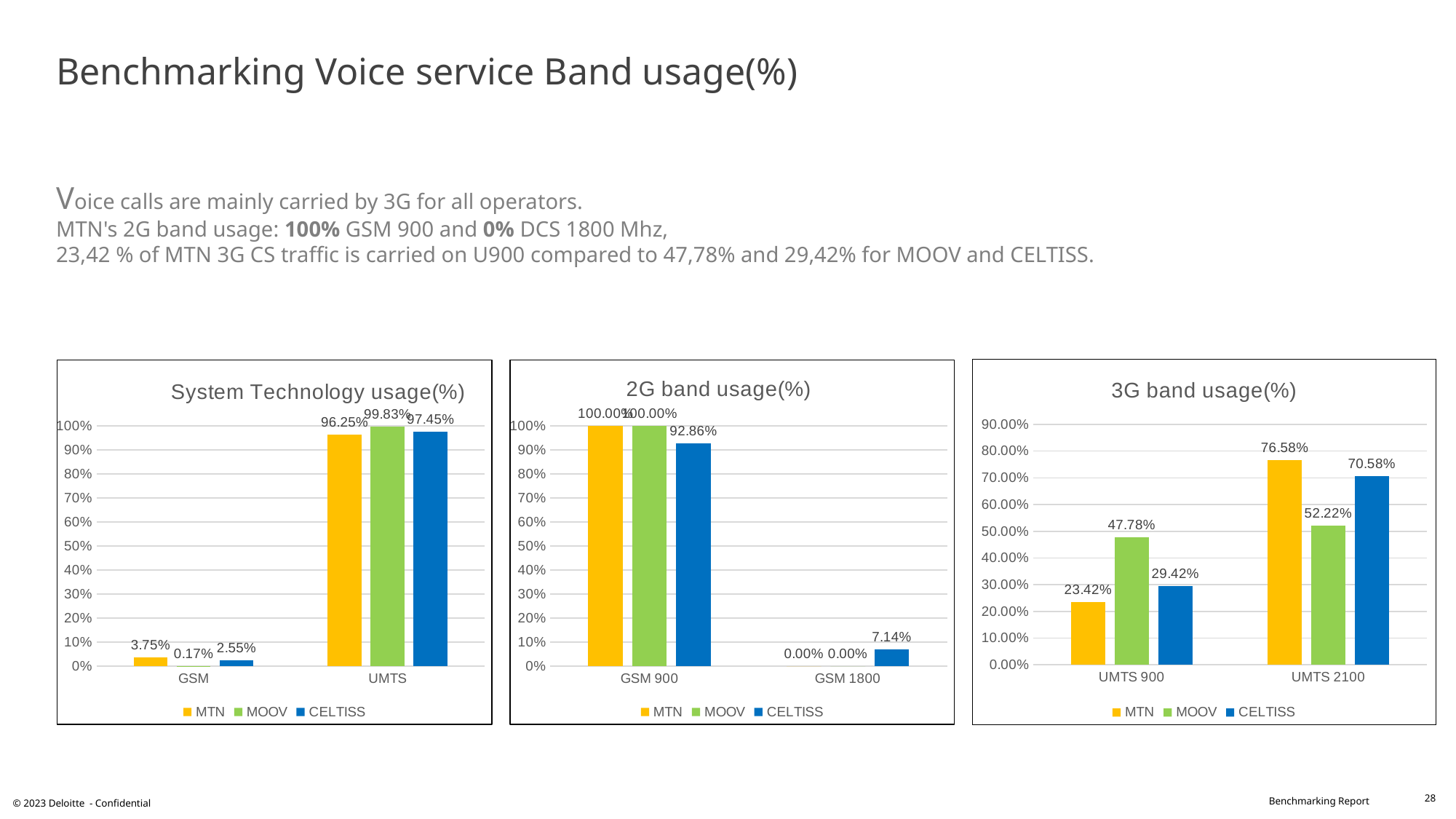
In the '2G band usage(%)' chart, what is the value for CELTISS in the GSM 1800 category? 7.14% How many series does the legend of the '3G band usage(%)' chart list? 3 What kind of chart is the '2G band usage(%)' chart? bar chart In the '3G band usage(%)' chart, what is the value for MOOV in the UMTS 900 category? 47.78% In the 'System Technology usage(%)' chart, what is the value for MTN in the GSM category? 3.75% In the '2G band usage(%)' chart, what is the value for CELTISS in the GSM 900 category? 92.86% In the '3G band usage(%)' chart, is the value for CELTISS in UMTS 2100 larger or smaller than the value for MOOV in UMTS 2100? larger In the '3G band usage(%)' chart, what is the difference between MTN's UMTS 2100 and UMTS 900 values? 53.16% In the '2G band usage(%)' chart, what is the difference between MTN and CELTISS in the GSM 900 category? 7.14% In the '3G band usage(%)' chart, which operator has the highest UMTS 2100 value? MTN In the 'System Technology usage(%)' chart, which operator has the lowest GSM value? MOOV In the 'System Technology usage(%)' chart, which operator has the highest UMTS value? MOOV